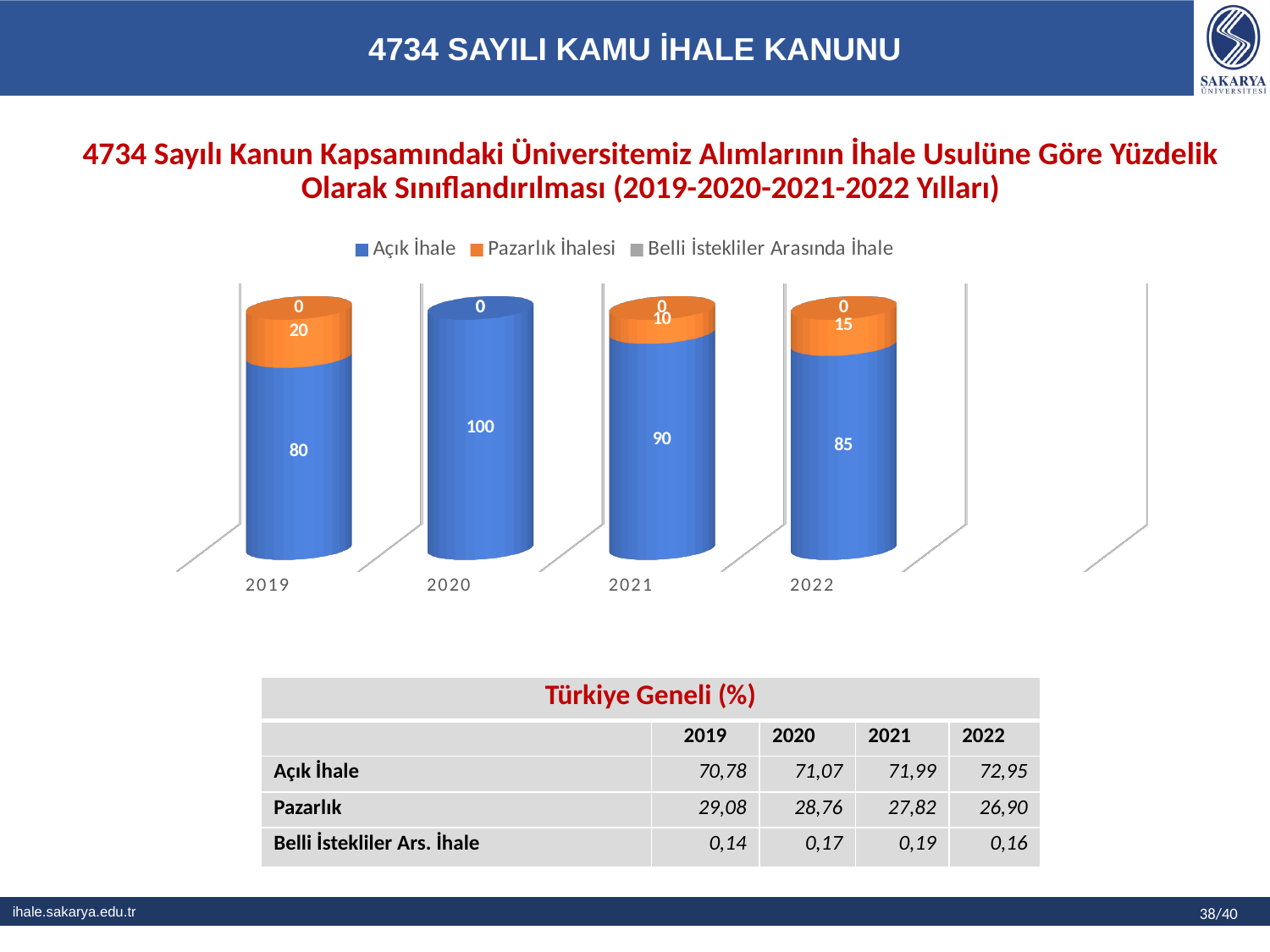
Which year has the highest Açık İhale value? 2020 Which is larger, the Pazarlık İhalesi value for 2022 or for 2021? 2022 What is the value of Açık İhale for 2022? 85 How many series does the chart legend list? 3 What is the difference between the Açık İhale values for 2020 and 2019? 20 What kind of chart is shown on the slide? Stacked bar chart Which year has the lowest Açık İhale value? 2019 What is the value of Açık İhale for 2020? 100 Which series is shown in orange in the chart? Pazarlık İhalesi What is the value of Pazarlık İhalesi for 2021? 10 How many years are shown on the x axis of the chart? 4 What is the value of Pazarlık İhalesi for 2019? 20